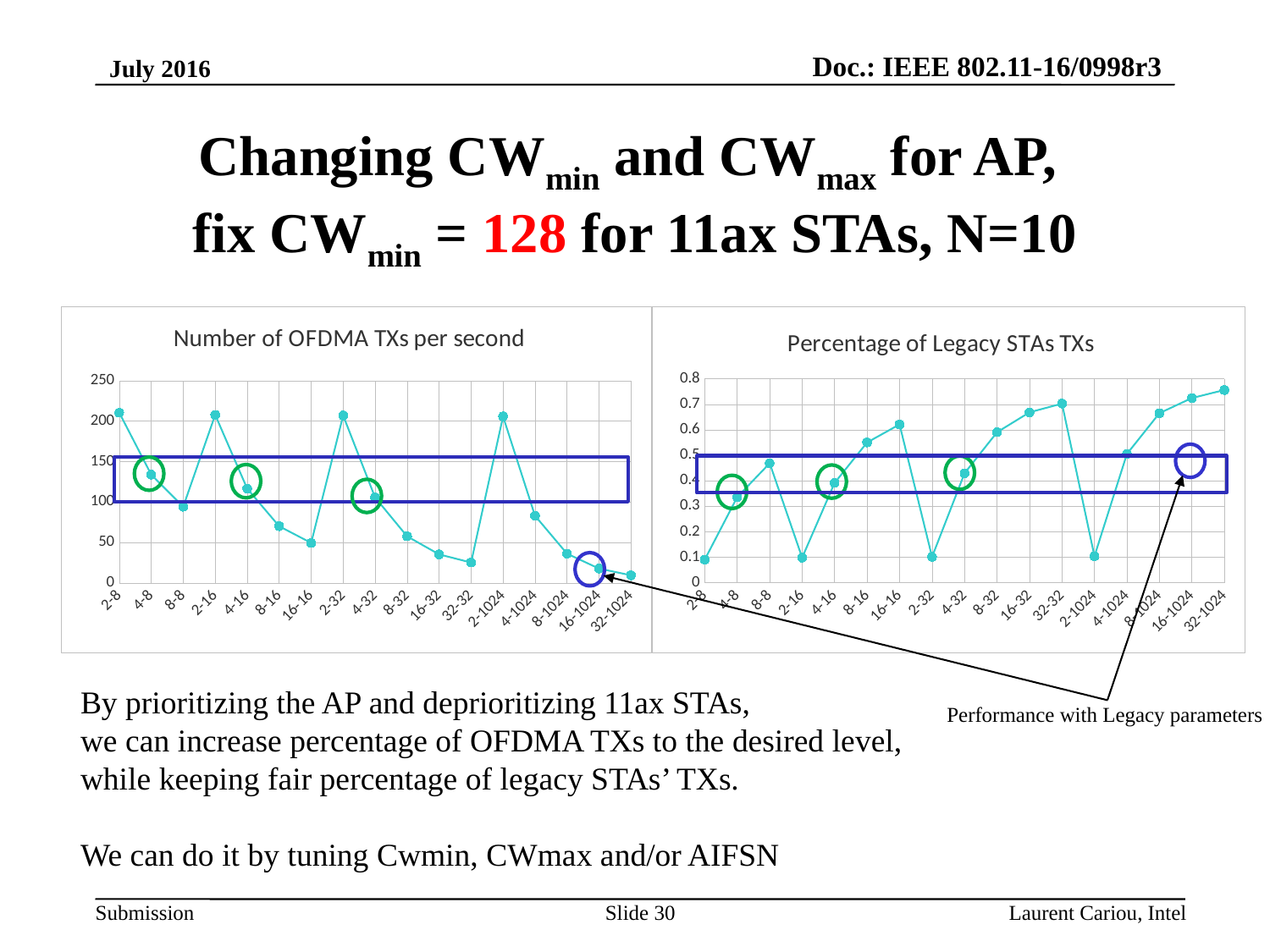
In the 'Number of OFDMA TXs per second' chart, which category has the lowest value? 32-1024 In the 'Number of OFDMA TXs per second' chart, which is larger, the value for 2-8 or the value for 8-8? 2-8 In the 'Percentage of Legacy STAs TXs' chart, which is larger, the value for 2-16 or the value for 16-16? 16-16 In the 'Number of OFDMA TXs per second' chart, is the value for 4-8 greater or less than 100? greater What is the title of the chart on the right side of the slide? Percentage of Legacy STAs TXs In the 'Number of OFDMA TXs per second' chart, do the values rise or fall from 2-1024 to 32-1024? fall In the 'Percentage of Legacy STAs TXs' chart, do the values rise or fall from 2-32 to 32-32? rise In the 'Percentage of Legacy STAs TXs' chart, is the value for 16-16 greater or less than 0.5? greater How many categories are plotted along the x axis of the 'Percentage of Legacy STAs TXs' chart? 17 What kind of chart is the 'Number of OFDMA TXs per second' chart on the left? line chart In the 'Number of OFDMA TXs per second' chart, is the value for 8-16 greater or less than 100? less